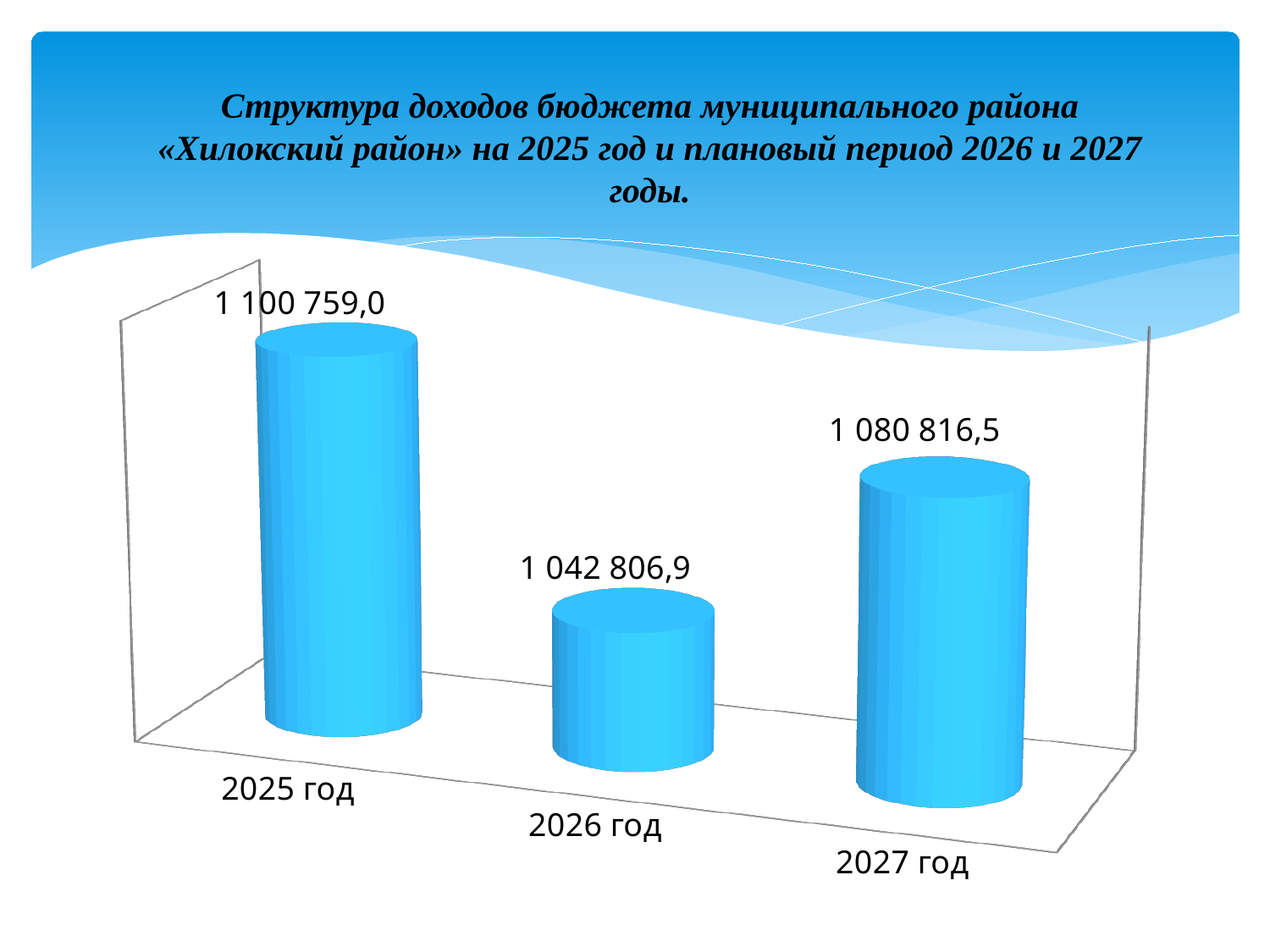
Which year has the highest value? 2025 год What is the difference between the values for 2025 год and 2026 год? 57 952,1 How many categories are shown on the chart? 3 Which is larger, the value for 2027 год or the value for 2026 год? 2027 год What is the value shown for 2026 год? 1 042 806,9 What is the difference between the values for 2027 год and 2026 год? 38 009,6 Does the value rise or fall from 2025 год to 2026 год? Fall What is the difference between the values for 2025 год and 2027 год? 19 942,5 What is the value shown for 2025 год? 1 100 759,0 What kind of chart is shown on the slide? Bar chart Which year has the lowest value? 2026 год What is the value shown for 2027 год? 1 080 816,5